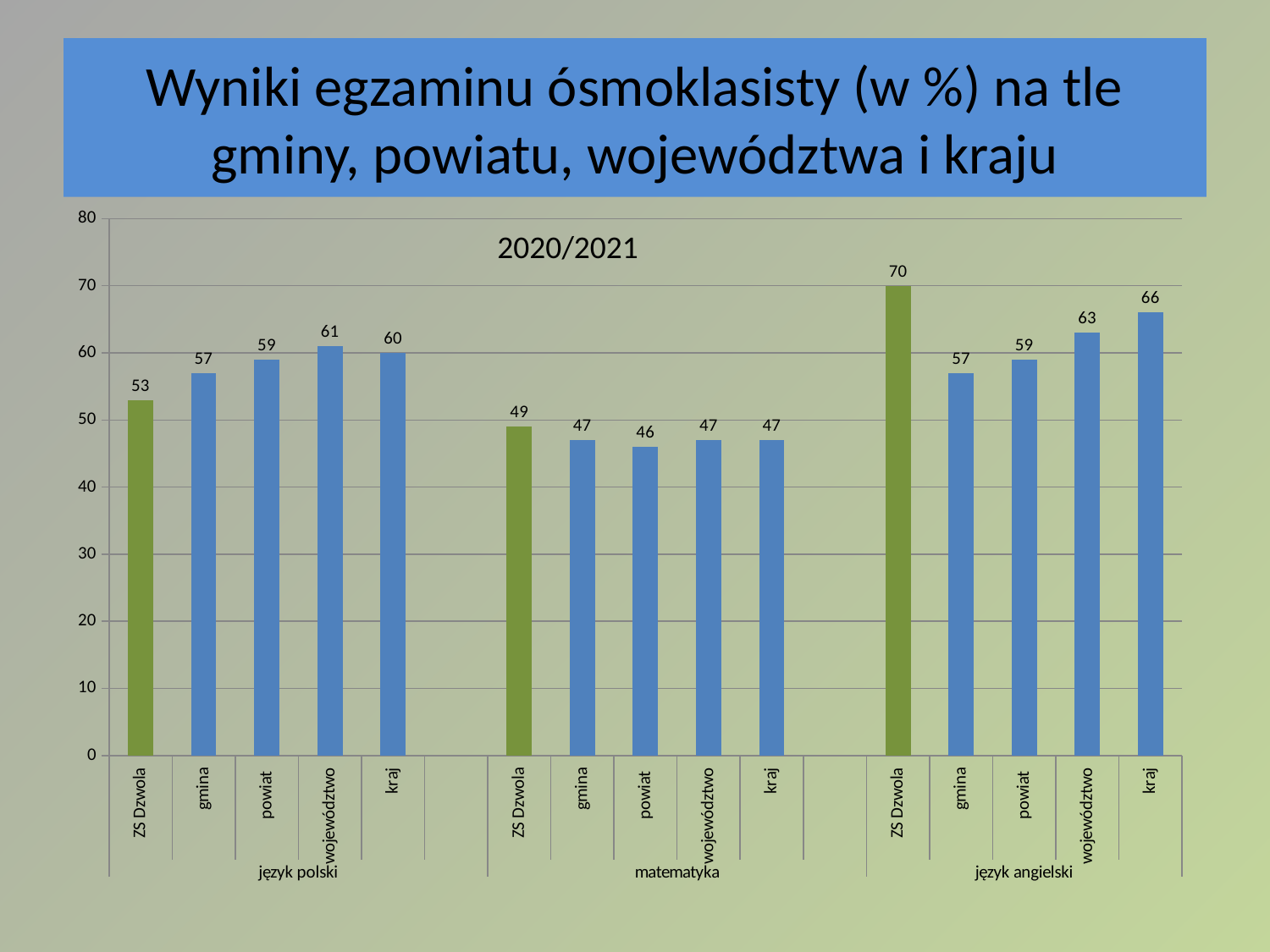
How many bars are plotted on the chart? 15 What is the value for ZS Dzwola in język polski? 53 What kind of chart is shown on the slide? bar chart Which bar has the lowest value on the chart? powiat (matematyka) What school year label is shown inside the chart? 2020/2021 What is the difference between województwo and ZS Dzwola in język polski? 8 Which bar has the highest value on the chart? ZS Dzwola (język angielski) What is the value for kraj in język angielski? 66 What is the difference between ZS Dzwola and kraj in język angielski? 4 What is the value for województwo in matematyka? 47 Which is larger: ZS Dzwola in matematyka or gmina in matematyka? ZS Dzwola in matematyka Is the value for ZS Dzwola in język angielski greater or less than 60? greater